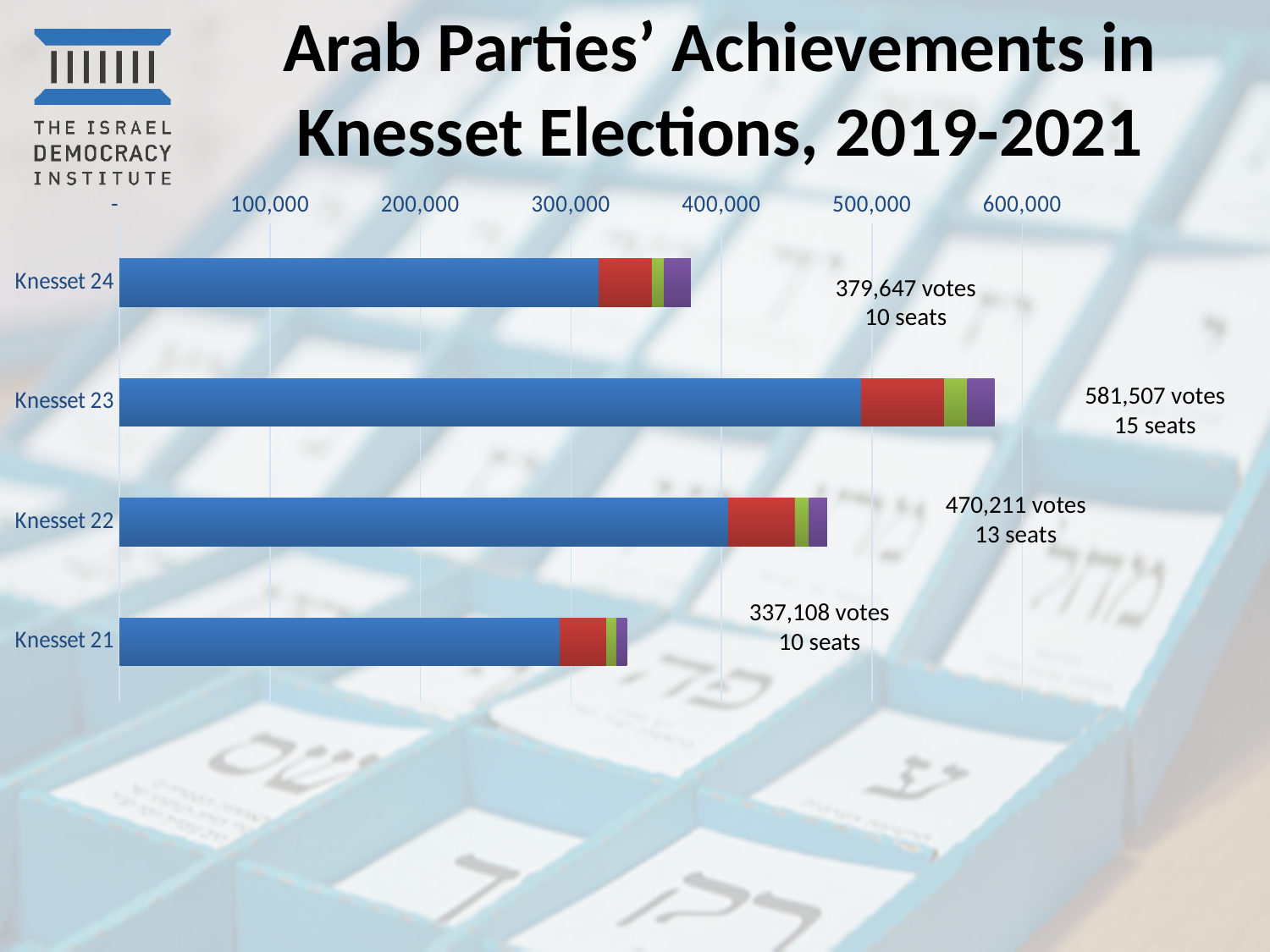
Which Knesset election had the lowest number of votes for the Arab parties? Knesset 21 How many seats did the Arab parties win in the Knesset 22 election? 13 seats What is the difference in votes between Knesset 23 and Knesset 24? 201,860 What type of chart is shown on the slide? Stacked bar chart What is the title of the slide? Arab Parties' Achievements in Knesset Elections, 2019-2021 How many votes are shown for Knesset 21? 337,108 votes Which Knesset election had the highest number of votes for the Arab parties? Knesset 23 How many more seats did the Arab parties win in Knesset 23 than in Knesset 21? 5 How many Knesset elections are shown in the chart? 4 Which had more votes for the Arab parties, Knesset 22 or Knesset 24? Knesset 22 How many votes did the Arab parties receive in the Knesset 23 election? 581,507 votes Is the total vote count for Knesset 24 greater or less than 400,000? less